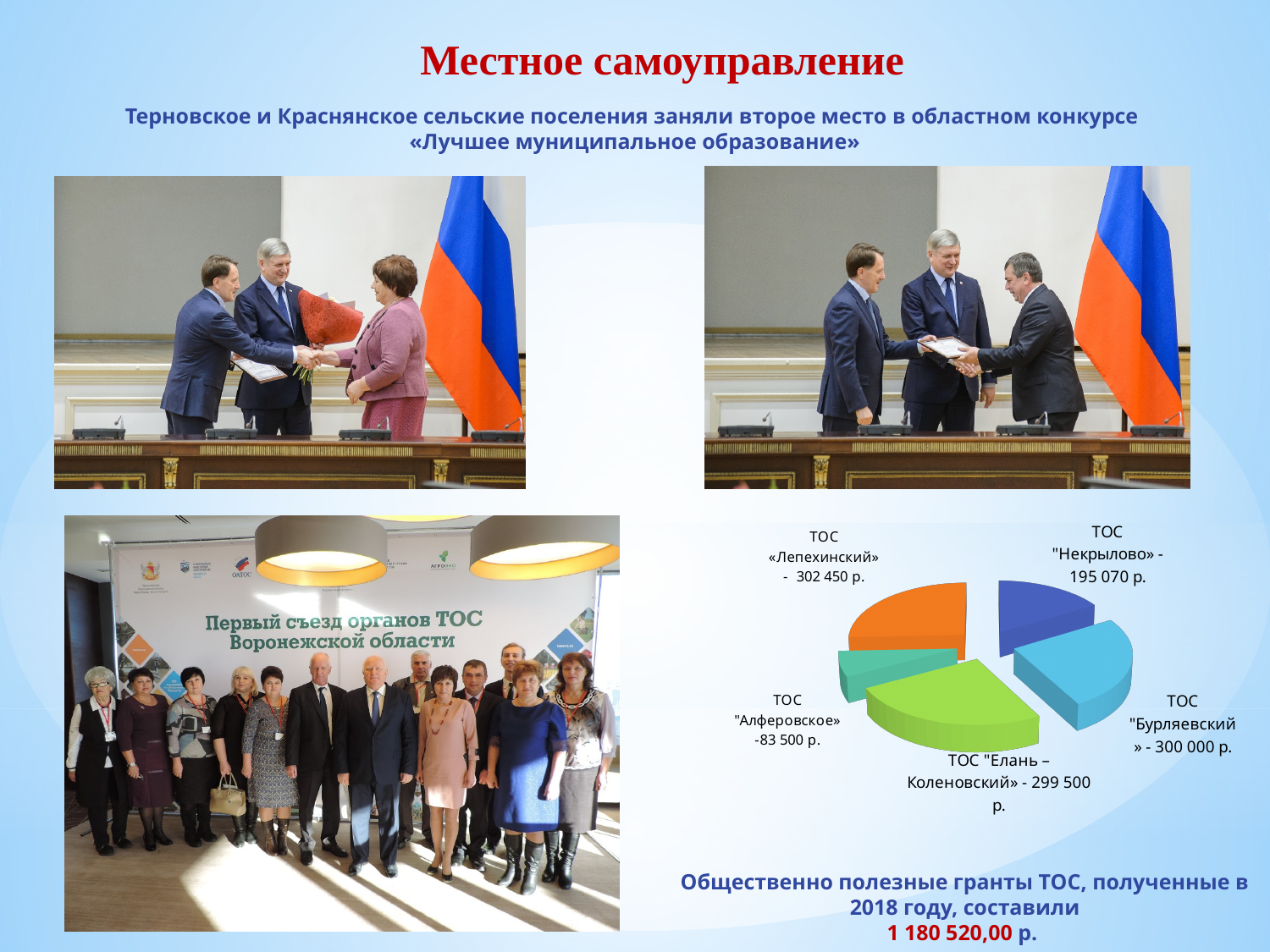
What is the value shown for ТОС "Елань – Коленовский" in the pie chart? 299 500 р. What colour is the slice for ТОС «Лепехинский» in the pie chart? Orange What is the difference between the grants of ТОС "Бурляевский" and ТОС "Некрылово"? 104 930 р. What kind of chart is shown on the slide? Pie chart How many slices does the pie chart have? 5 Which received a larger grant: ТОС "Бурляевский" or ТОС "Елань – Коленовский"? ТОС "Бурляевский" Which ТОС received the smallest grant according to the pie chart? ТОС "Алферовское" What is the value shown for ТОС «Лепехинский» in the pie chart? 302 450 р. Which ТОС received the largest grant according to the pie chart? ТОС «Лепехинский» What total amount of ТОС grants received in 2018 is stated on the slide? 1 180 520,00 р. What is the value shown for ТОС "Некрылово" in the pie chart? 195 070 р. What is the value shown for ТОС "Алферовское" in the pie chart? 83 500 р.